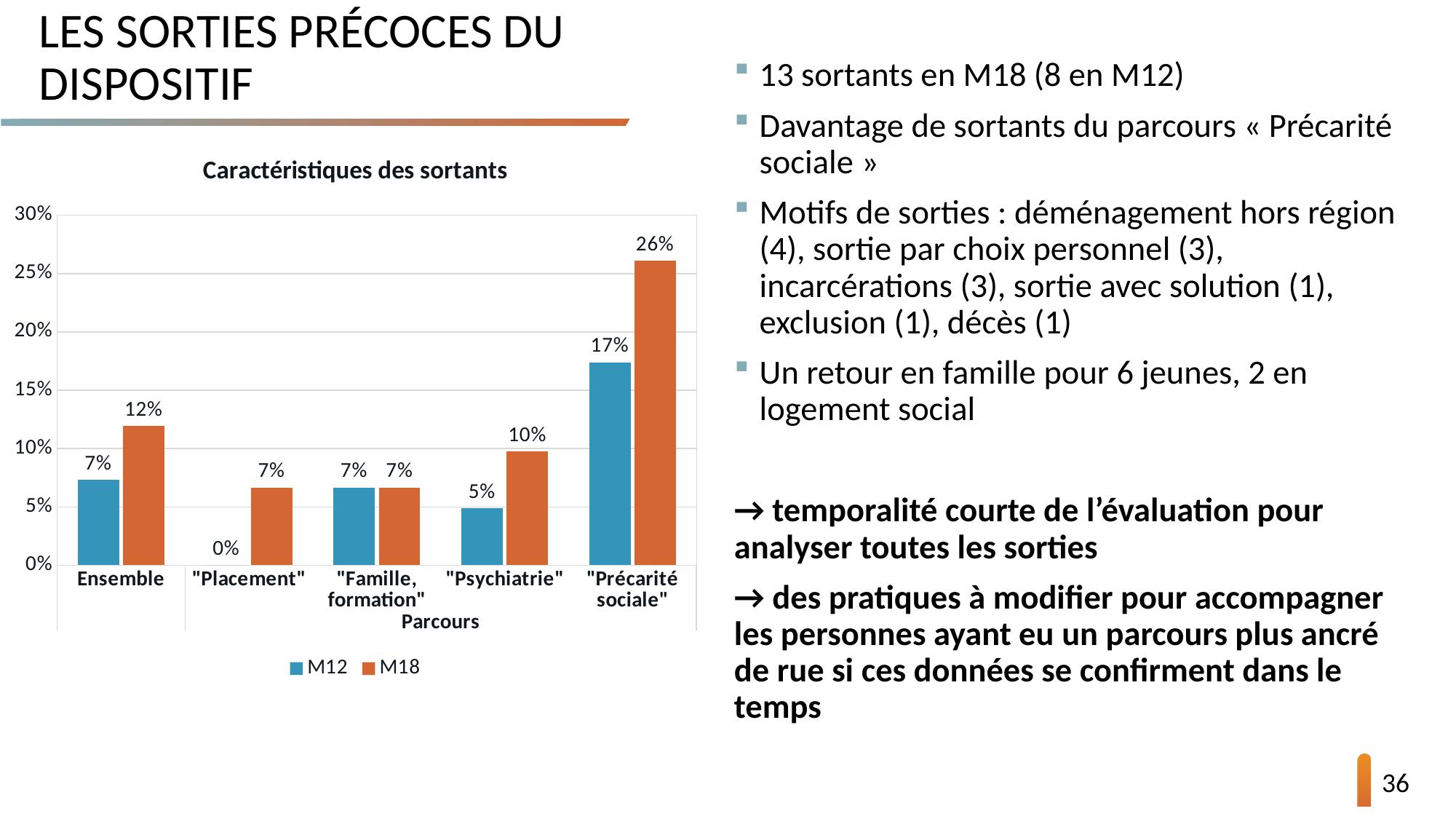
What type of chart is shown on the slide? Bar chart What is the M18 value for Ensemble? 12% What is the M12 value for "Psychiatrie"? 5% Which category has the highest M18 value? "Précarité sociale" How many series does the legend list? 2 Is the M18 value for "Précarité sociale" greater or less than 25%? greater Which category has the lowest M12 value? "Placement" Which is larger for "Psychiatrie": the M12 value or the M18 value? M18 What is the difference between the M18 and M12 values for "Précarité sociale"? 9% How many categories are shown on the x axis? 5 What is the M12 value for "Placement"? 0% What is the M18 value for "Précarité sociale"? 26%